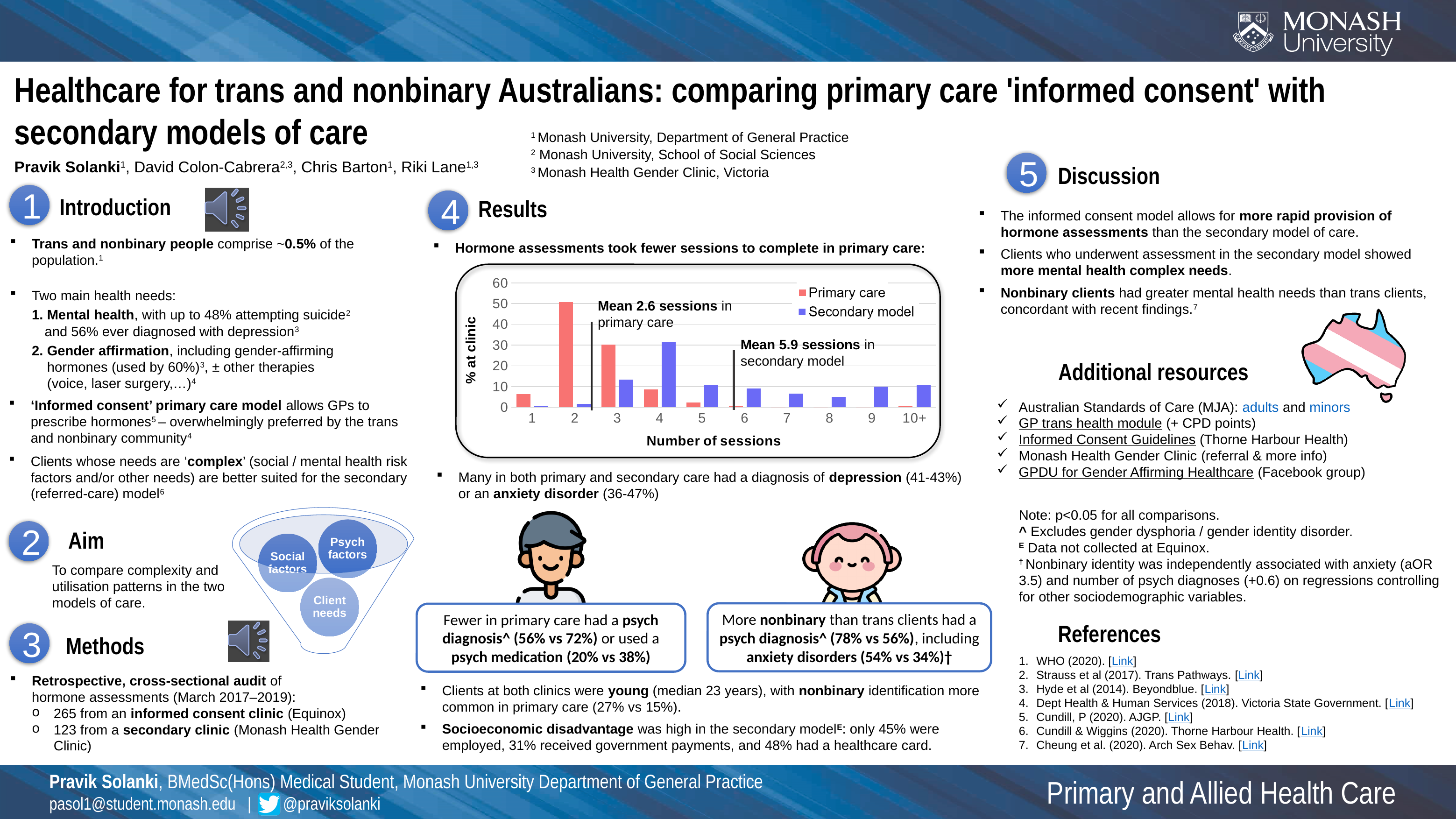
What is the label of the y axis on the sessions chart? % at clinic At 3 sessions, which series has the larger value, Primary care or Secondary model? Primary care What kind of chart is shown in the Results section? bar chart In the sessions chart, which number of sessions has the highest percentage for Primary care? 2 In the sessions chart, which number of sessions has the highest percentage for the Secondary model? 4 Is the Secondary model value for 1 session greater or less than 10? less At 5 sessions, which series has the larger value, Primary care or Secondary model? Secondary model How many categories are shown on the x axis of the sessions chart? 10 Is the Secondary model value for 4 sessions greater or less than 20? greater How many series does the legend of the sessions chart list? 2 Is the Primary care value for 2 sessions greater or less than 40? greater According to the annotation on the chart, what is the mean number of sessions in primary care? 2.6 sessions